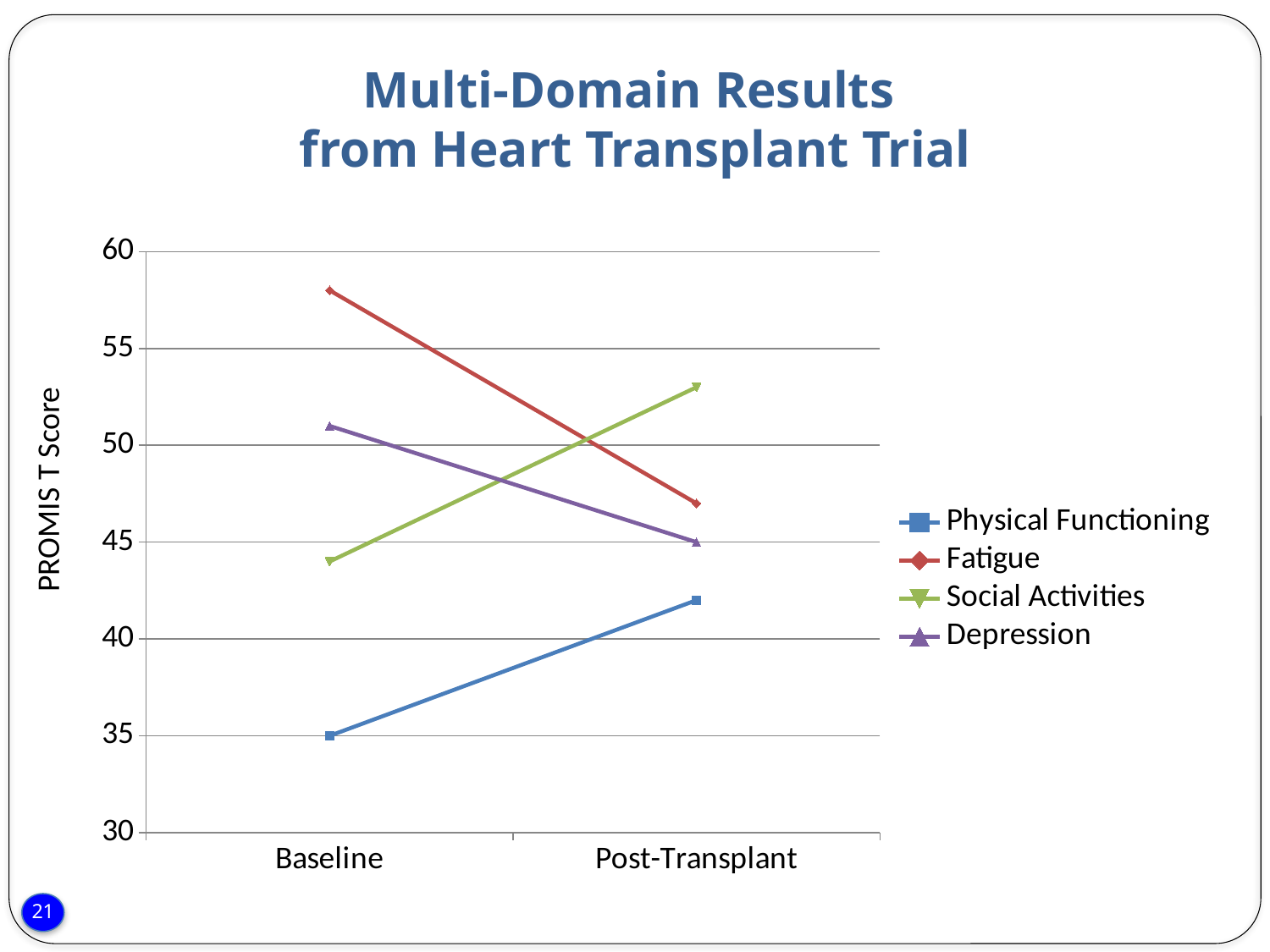
What kind of chart is shown on the slide? line chart What is the label of the y axis? PROMIS T Score What is the Physical Functioning value at Baseline? 35 Is the Fatigue value at Post-Transplant greater or less than 50? less Which series has the lowest value at Post-Transplant? Physical Functioning Does the Fatigue line rise or fall from Baseline to Post-Transplant? fall How many series does the legend list? 4 At Post-Transplant, which is larger: Social Activities or Depression? Social Activities Is the Social Activities value at Baseline greater or less than 45? less How many categories are shown on the x axis? 2 Does the Social Activities line rise or fall from Baseline to Post-Transplant? rise Which series has the highest value at Baseline? Fatigue